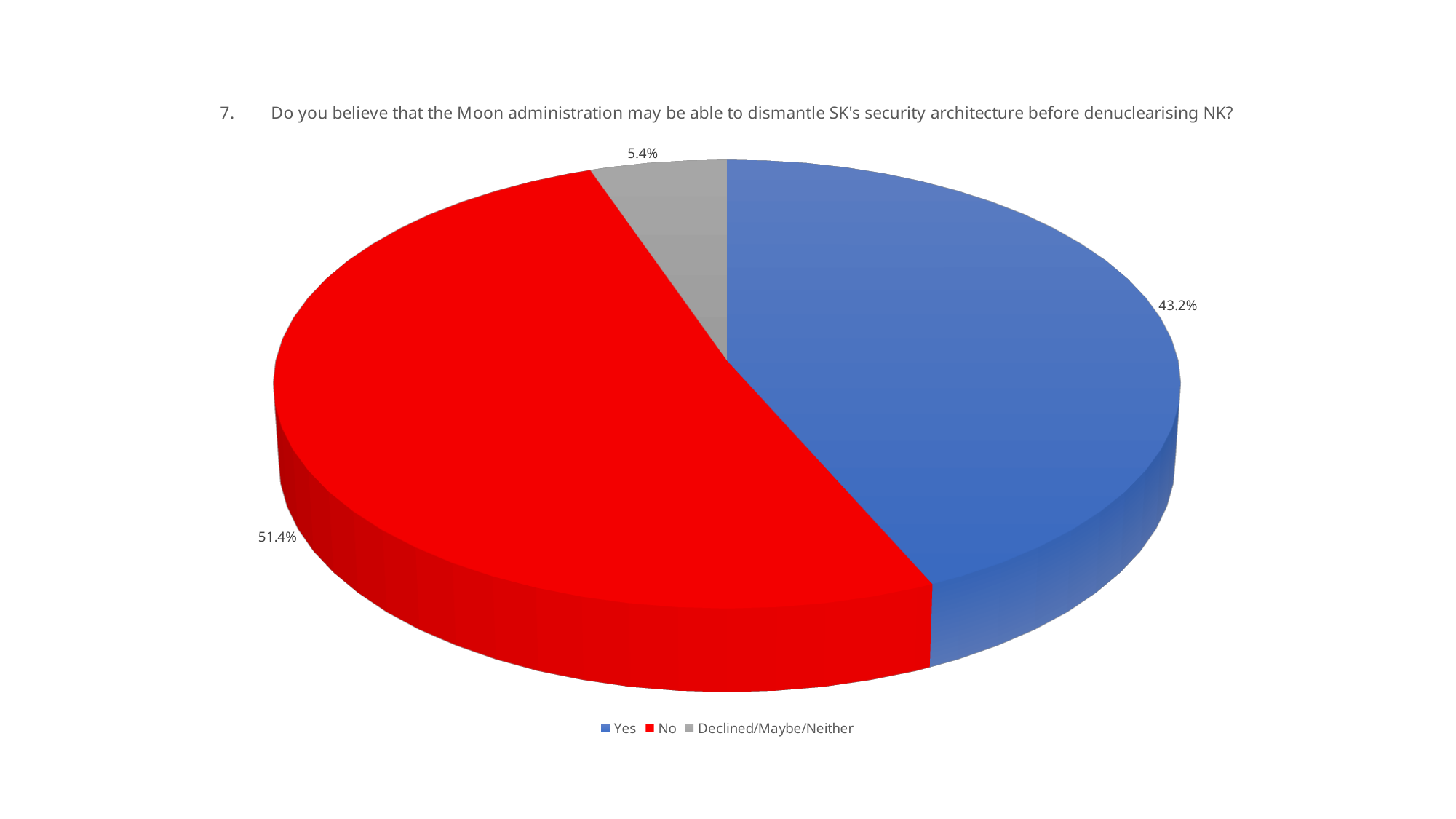
Which response category has the smallest share of the pie? Declined/Maybe/Neither What type of chart is shown on the slide? Pie chart What percentage of respondents answered "Yes"? 43.2% What percentage of respondents are in the "Declined/Maybe/Neither" category? 5.4% How many entries does the legend list? 3 What is the title of the chart? Do you believe that the Moon administration may be able to dismantle SK's security architecture before denuclearising NK? What percentage of respondents answered "No"? 51.4% Which is larger, the share for "Yes" or the share for "No"? No What colour represents the "No" category in the pie chart? Red What is the difference in percentage points between the "No" share and the "Yes" share? 8.2 Which response category has the largest share of the pie? No How many categories does the pie chart show? 3